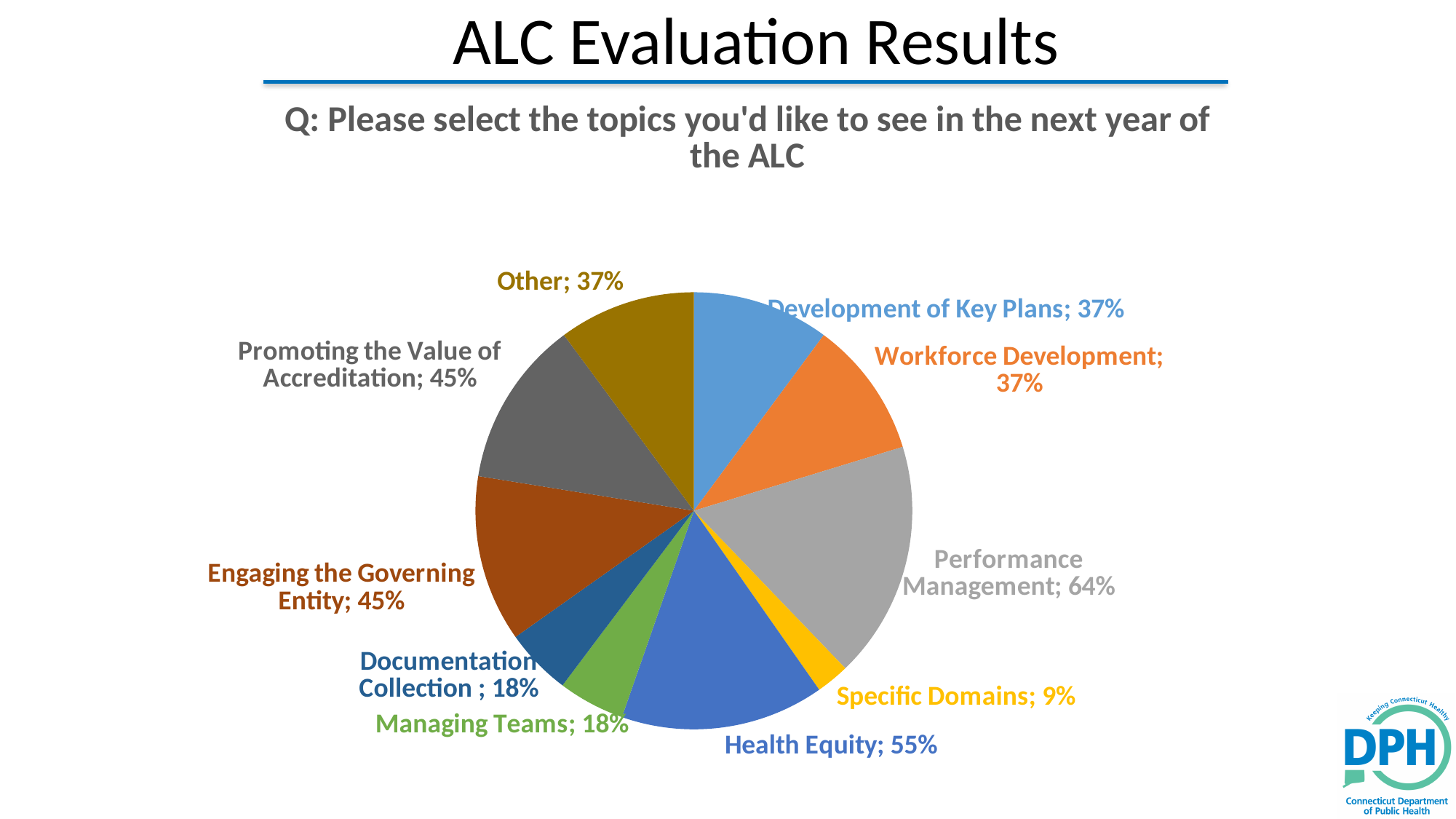
What percentage is shown for Specific Domains? 9% What percentage is shown for Engaging the Governing Entity? 45% Which has a larger percentage, Workforce Development or Health Equity? Health Equity What question is the pie chart summarizing responses to? Please select the topics you'd like to see in the next year of the ALC What percentage is shown for Performance Management? 64% What is the difference between the percentages for Performance Management and Health Equity? 9% What percentage is shown for Health Equity? 55% Which topic has the lowest percentage? Specific Domains What kind of chart is shown on the slide? pie chart Which topic has the highest percentage? Performance Management What is the difference between the percentages for Promoting the Value of Accreditation and Managing Teams? 27% How many topics (slices) are shown in the pie chart? 10